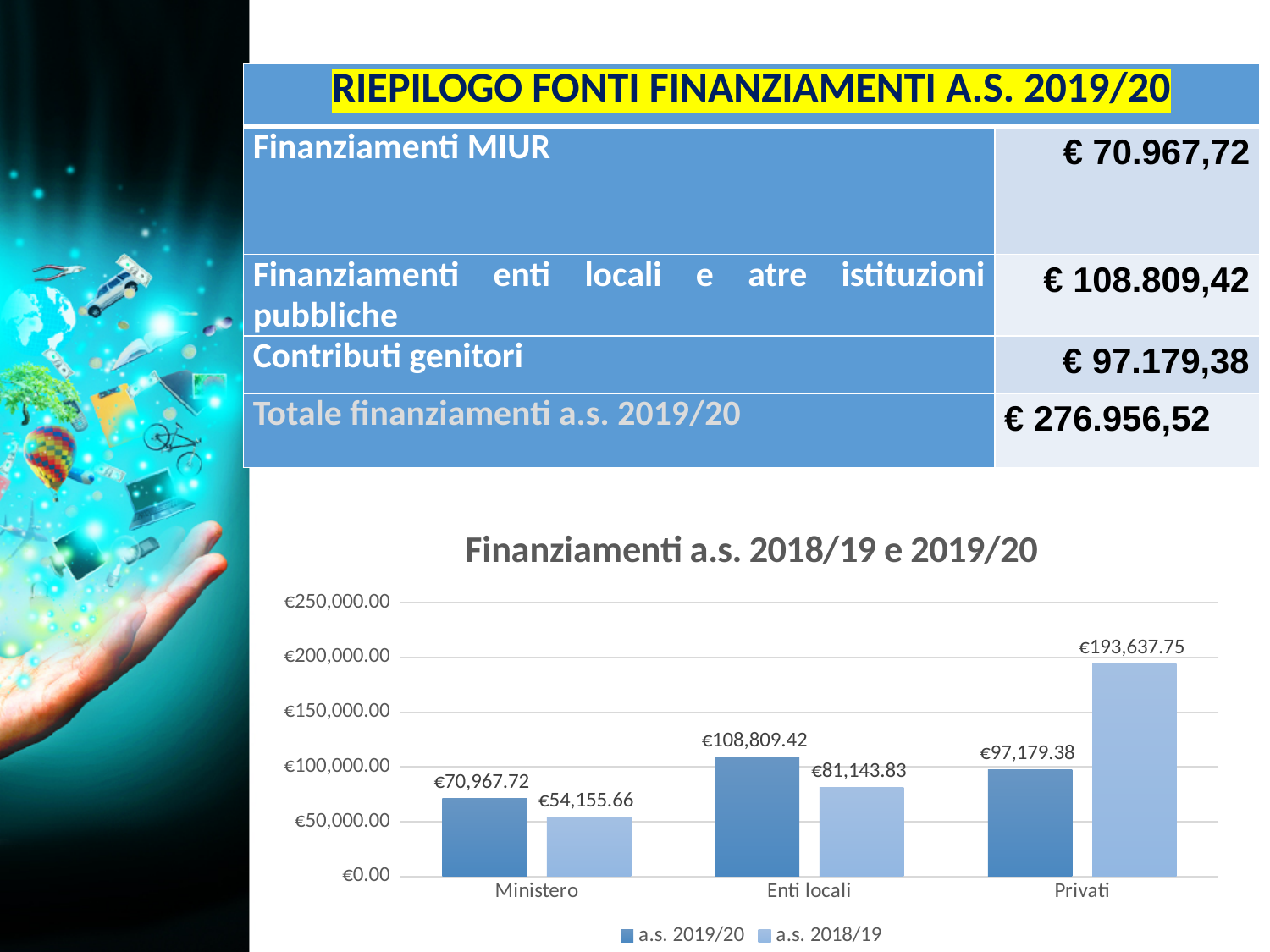
Which category has the lowest value in the a.s. 2019/20 series? Ministero Which category has the highest value in the a.s. 2018/19 series? Privati What is the title of the chart? Finanziamenti a.s. 2018/19 e 2019/20 What is the value for Privati in the a.s. 2018/19 series? €193,637.75 What is the value for Enti locali in the a.s. 2019/20 series? €108,809.42 Is the value for Ministero in the a.s. 2018/19 series greater or less than €100,000.00? less How many series does the chart legend list? 2 How many categories are shown on the x axis of the chart? 3 What type of chart is shown on the slide? bar chart What is the value for Ministero in the a.s. 2019/20 series? €70,967.72 What is the difference between the a.s. 2019/20 and a.s. 2018/19 values for Enti locali? €27,665.59 For Privati, which series has the larger value, a.s. 2019/20 or a.s. 2018/19? a.s. 2018/19